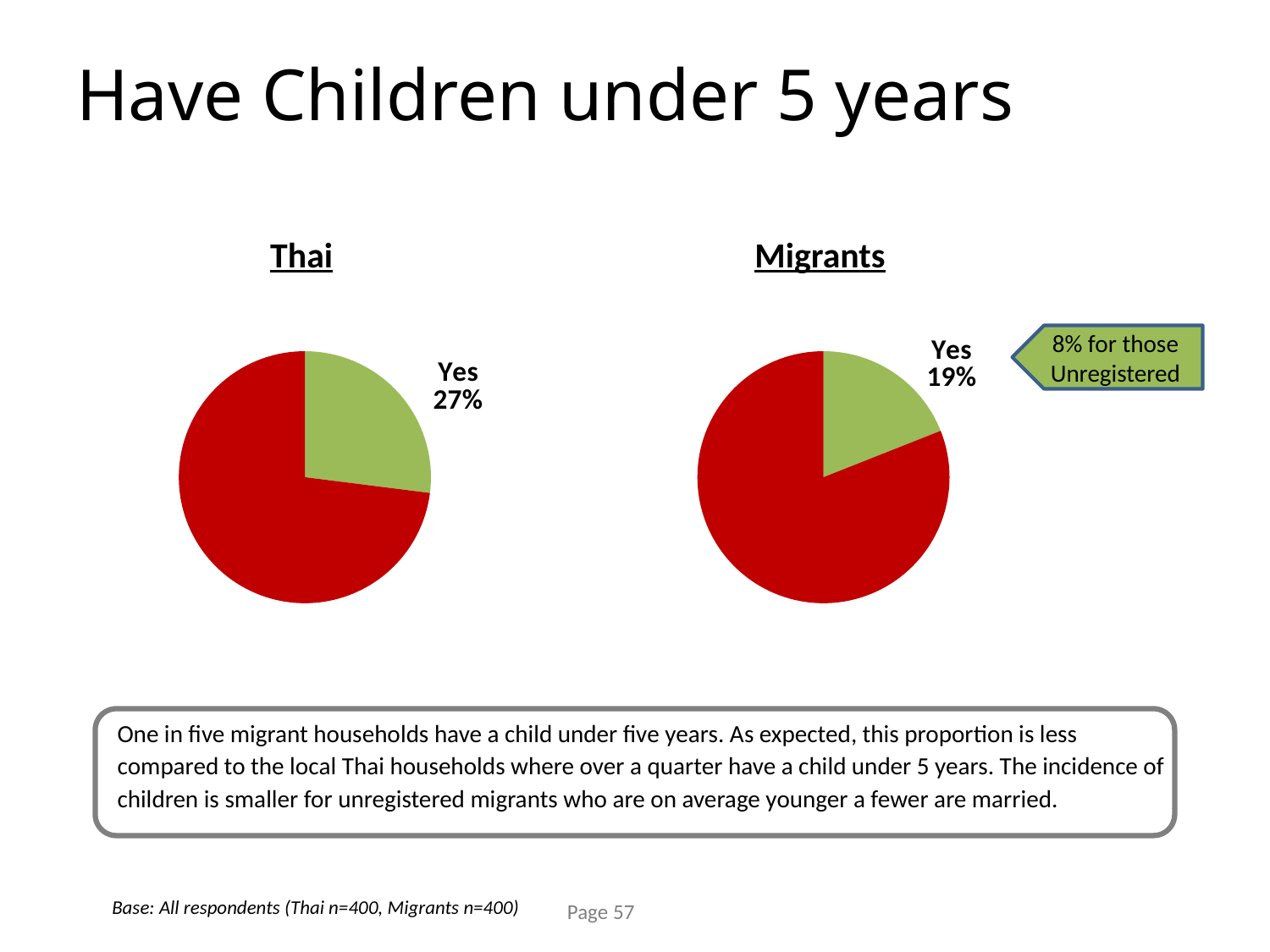
In the Migrants pie chart, what percentage answered Yes? 19% What colour is the Yes slice in both pie charts? Green What is the difference in percentage points between the Thai Yes share (27%) and the Migrants Yes share (19%)? 8 percentage points In the Thai pie chart, what percentage of households answered Yes to having children under 5 years? 27% What is the title of the slide containing the two pie charts? Have Children under 5 years What kind of chart is used for the Thai and Migrants data? Pie chart In the Thai pie chart, is the Yes slice larger or smaller than the other slice? Smaller Which group has the larger Yes share, Thai or Migrants? Thai In the Migrants pie chart, is the Yes slice larger or smaller than the other slice? Smaller How many slices does the Thai pie chart have? 2 How many pie charts are shown on the slide? 2